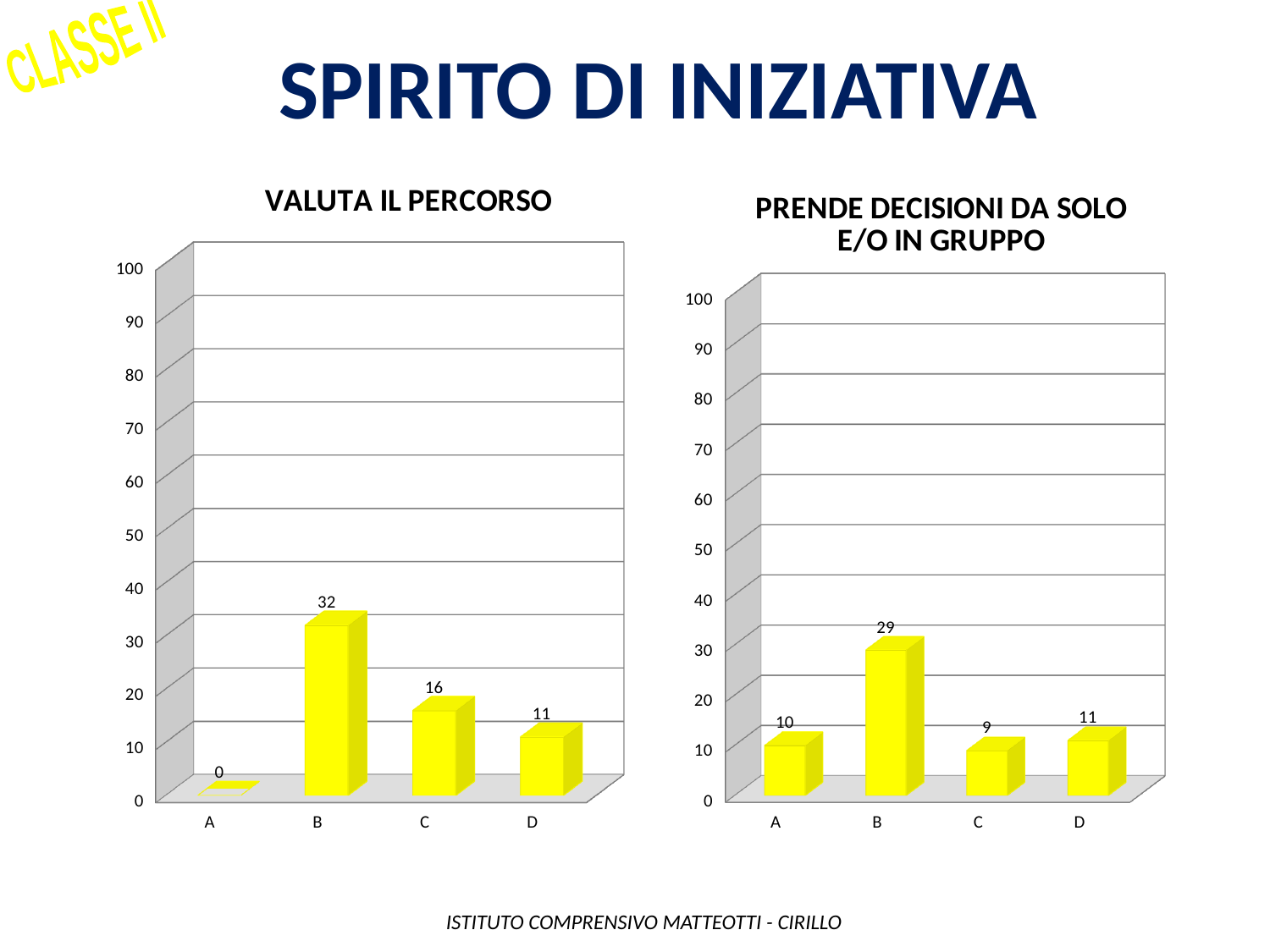
In the 'PRENDE DECISIONI DA SOLO E/O IN GRUPPO' chart, what is the value for category C? 9 In the 'PRENDE DECISIONI DA SOLO E/O IN GRUPPO' chart, which is larger, the value for A or the value for D? D In the 'VALUTA IL PERCORSO' chart, what is the difference between the values for B and C? 16 In the 'PRENDE DECISIONI DA SOLO E/O IN GRUPPO' chart, what is the difference between the values for B and D? 18 How many categories are shown on the x axis of the 'VALUTA IL PERCORSO' chart? 4 In the 'VALUTA IL PERCORSO' chart, is the value for B greater or less than 30? greater In the 'PRENDE DECISIONI DA SOLO E/O IN GRUPPO' chart, which category has the highest value? B What kind of chart is the 'PRENDE DECISIONI DA SOLO E/O IN GRUPPO' chart? Bar chart What is the title of the chart on the left side of the slide? VALUTA IL PERCORSO In the 'VALUTA IL PERCORSO' chart, what is the value for category B? 32 In the 'VALUTA IL PERCORSO' chart, which category has the lowest value? A In the 'VALUTA IL PERCORSO' chart, what is the value for category A? 0